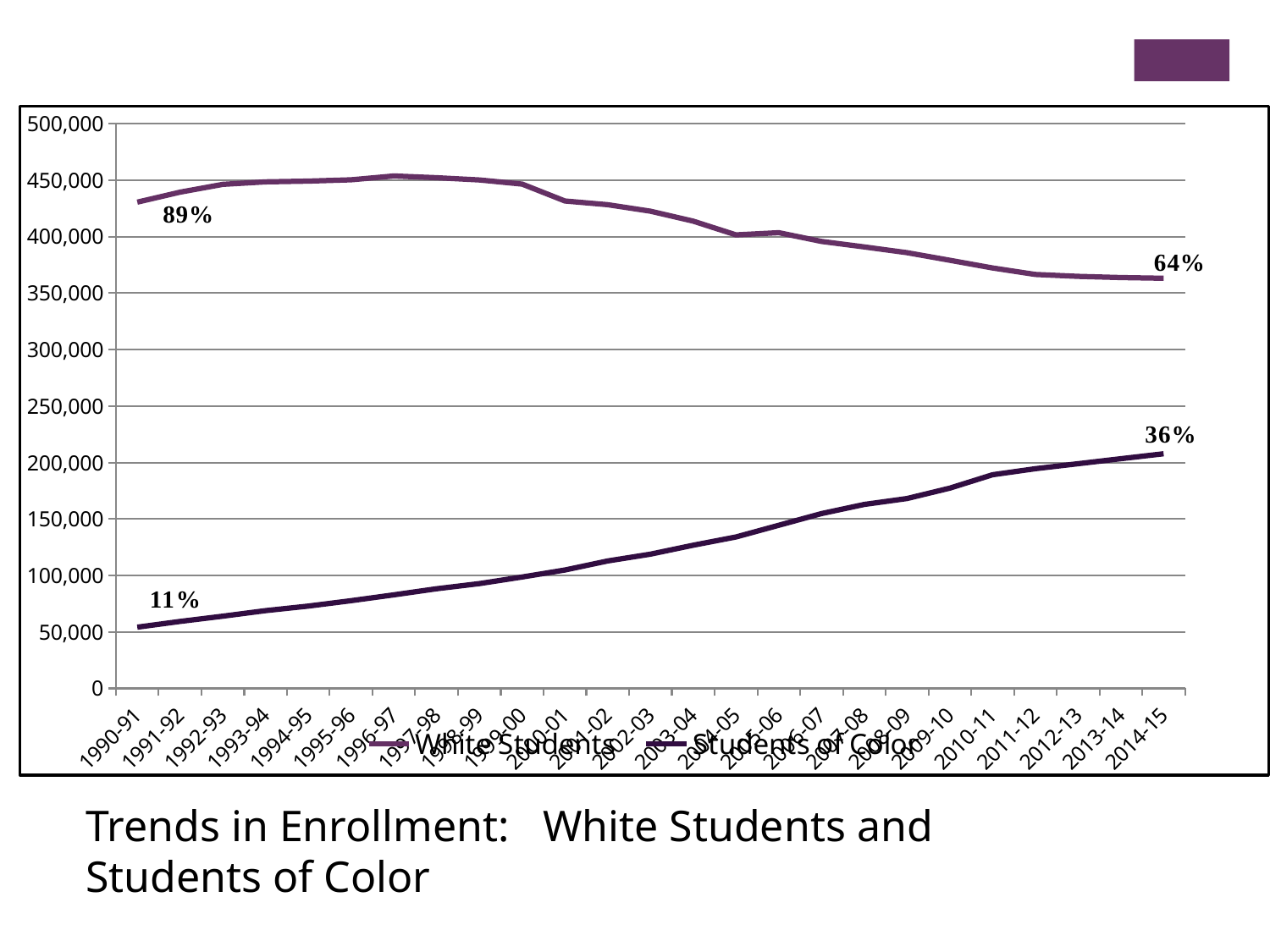
What percentage label is printed at the 2014-15 end of the White Students line? 64% Does the Students of Color line rise or fall from 1990-91 to 2014-15? rises How many series does the legend list? 2 What type of chart is shown on the slide? line chart Is the value for Students of Color in 1990-91 greater or less than 100,000? less In which school year is the Students of Color value lowest? 1990-91 In which school year is the Students of Color value highest? 2014-15 Is the value for White Students in 1990-91 greater or less than 400,000? greater Which series has the higher value in 2014-15, White Students or Students of Color? White Students Does the White Students line rise or fall from 1999-00 to 2014-15? falls How many school years are plotted along the x axis? 25 What percentage label is printed at the 1990-91 start of the Students of Color line? 11%